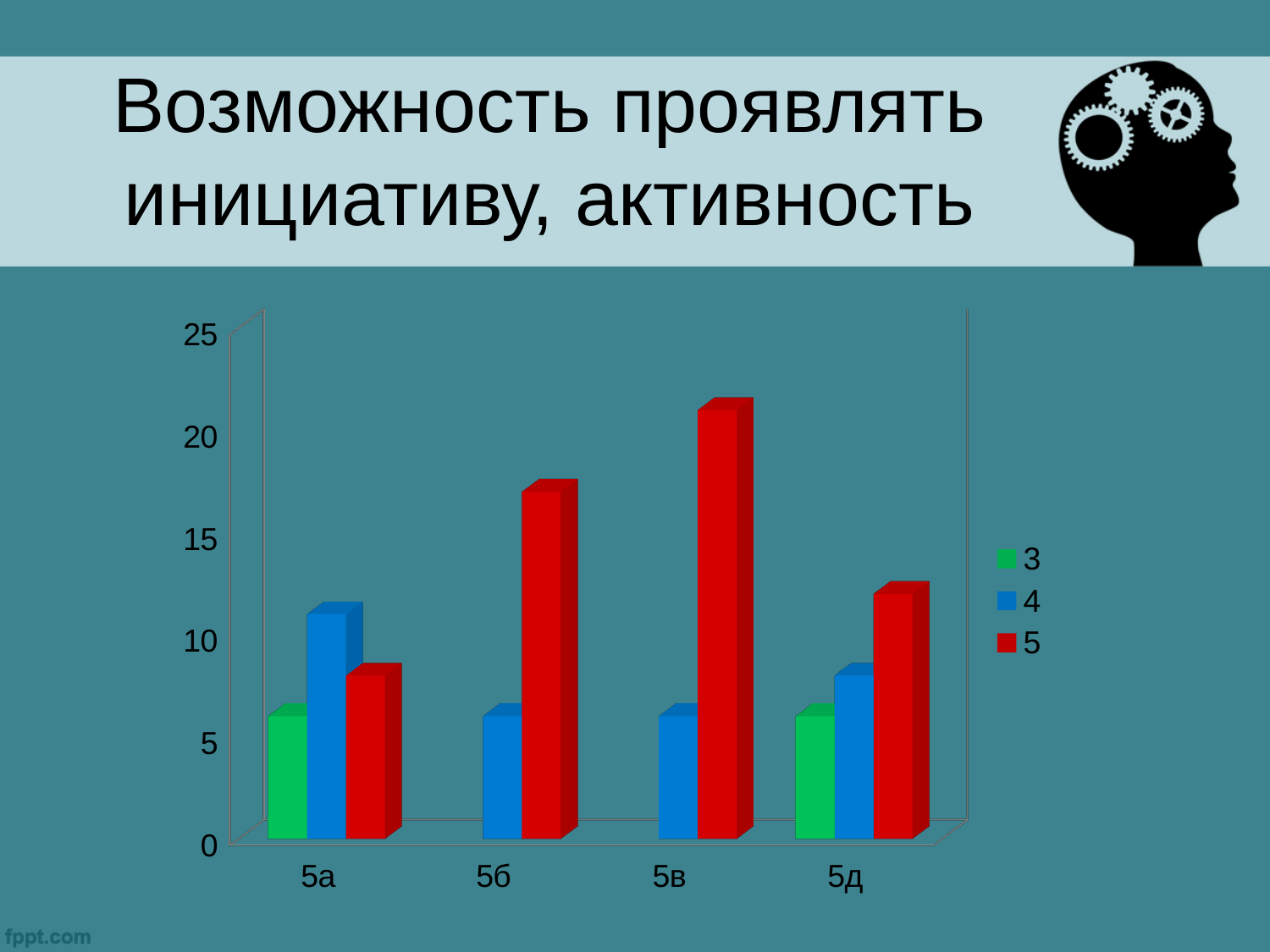
Which category has the highest value for series 5? 5в Which category has the lowest value for series 5? 5а Is the value for series 5 in category 5б greater or less than 15? greater Within category 5а, which series has the tallest bar? 4 What kind of chart is shown on the slide? bar chart Is the value for series 3 in category 5д greater or less than 10? less How many categories are shown on the x axis of the chart? 4 Is the value for series 5 in category 5а greater or less than 10? less Which is larger: the value for series 5 in category 5в or in category 5б? 5в What are the entries listed in the chart's legend? 3, 4, 5 How many series does the chart's legend list? 3